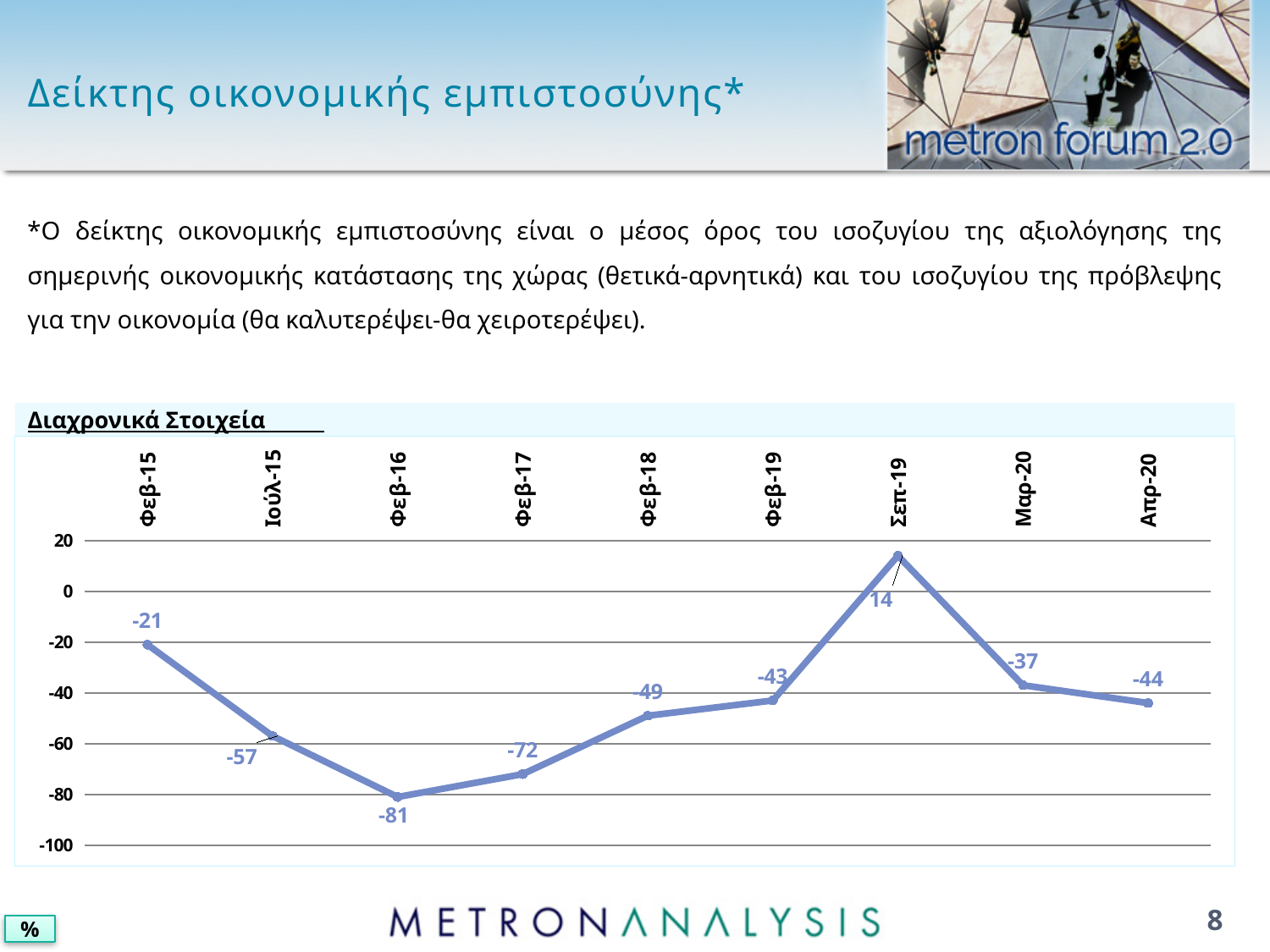
Which is larger, the value for Φεβ-18 or the value for Φεβ-19? Φεβ-19 What kind of chart is shown on the slide? Line chart Which period has the lowest value on the chart? Φεβ-16 What is the difference between the values for Φεβ-15 and Ιούλ-15? 36 What is the value of the economic confidence index for Φεβ-15? -21 What is the value of the economic confidence index for Σεπ-19? 14 What is the value of the economic confidence index for Φεβ-17? -72 Which period has the highest value on the chart? Σεπ-19 What is the difference between the values for Σεπ-19 and Μαρ-20? 51 How many time periods are plotted on the chart? 9 What is the value of the economic confidence index for Απρ-20? -44 Does the index rise or fall from Φεβ-16 to Σεπ-19? Rise